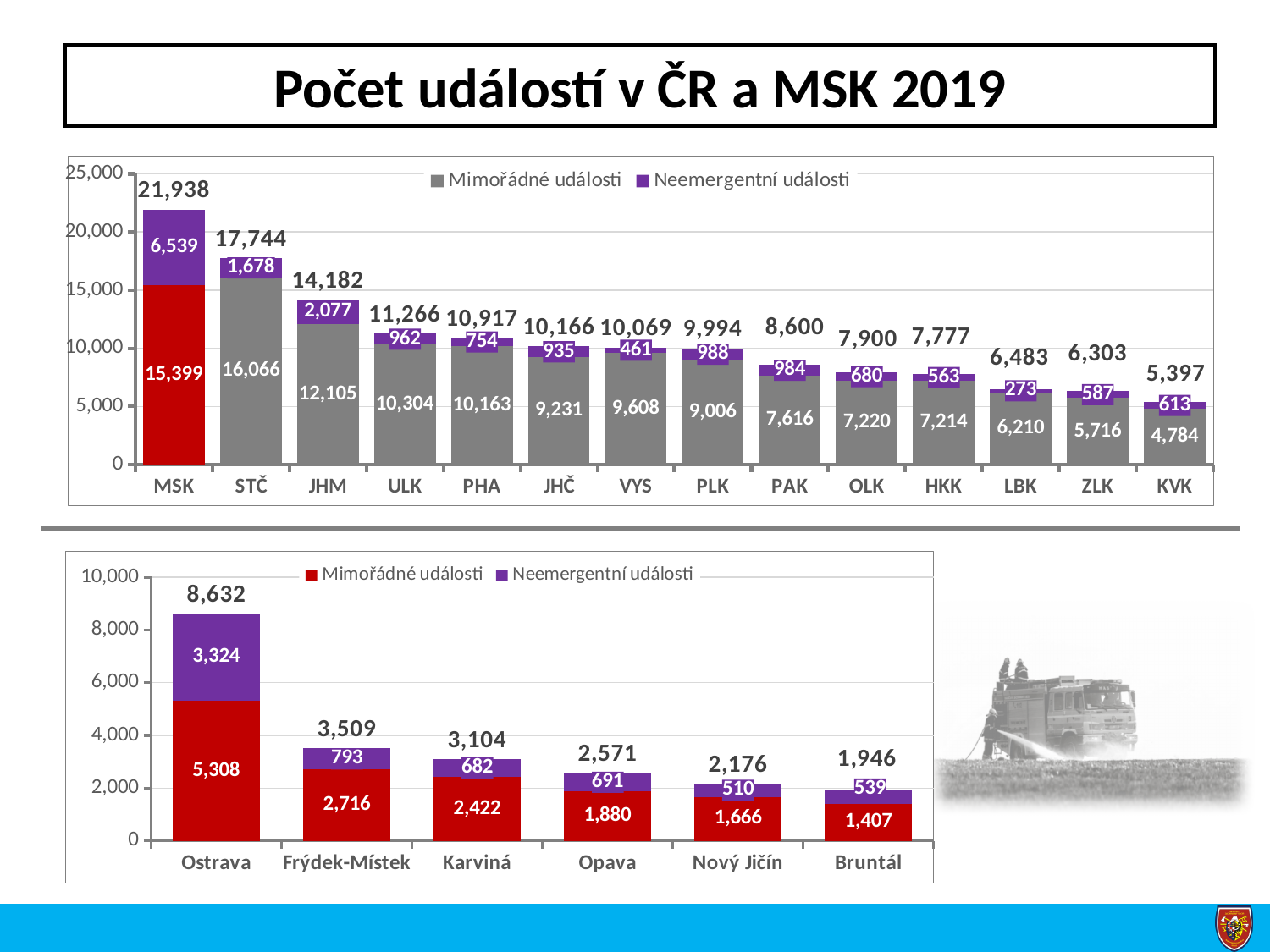
How many series does the legend of the bottom chart list? 2 In the bottom chart, what is the Neemergentní události value for Opava? 691 In the bottom chart, which is larger: the total for Frýdek-Místek or the total for Karviná? Frýdek-Místek In the top chart, what is the difference between the totals for MSK and STČ? 4,194 In the top chart, how many regions are shown on the x axis? 14 In the bottom chart, which district has the lowest total number of events? Bruntál In the top chart, which region has the lowest total number of events? KVK In the top chart, what is the Mimořádné události value for MSK? 15,399 In the top chart, which region has the highest total number of events? MSK In the top chart, what is the total shown above the stacked bar for STČ? 17,744 In the bottom chart, what is the Mimořádné události value for Ostrava? 5,308 In the top chart, what is the Neemergentní události value for JHM? 2,077